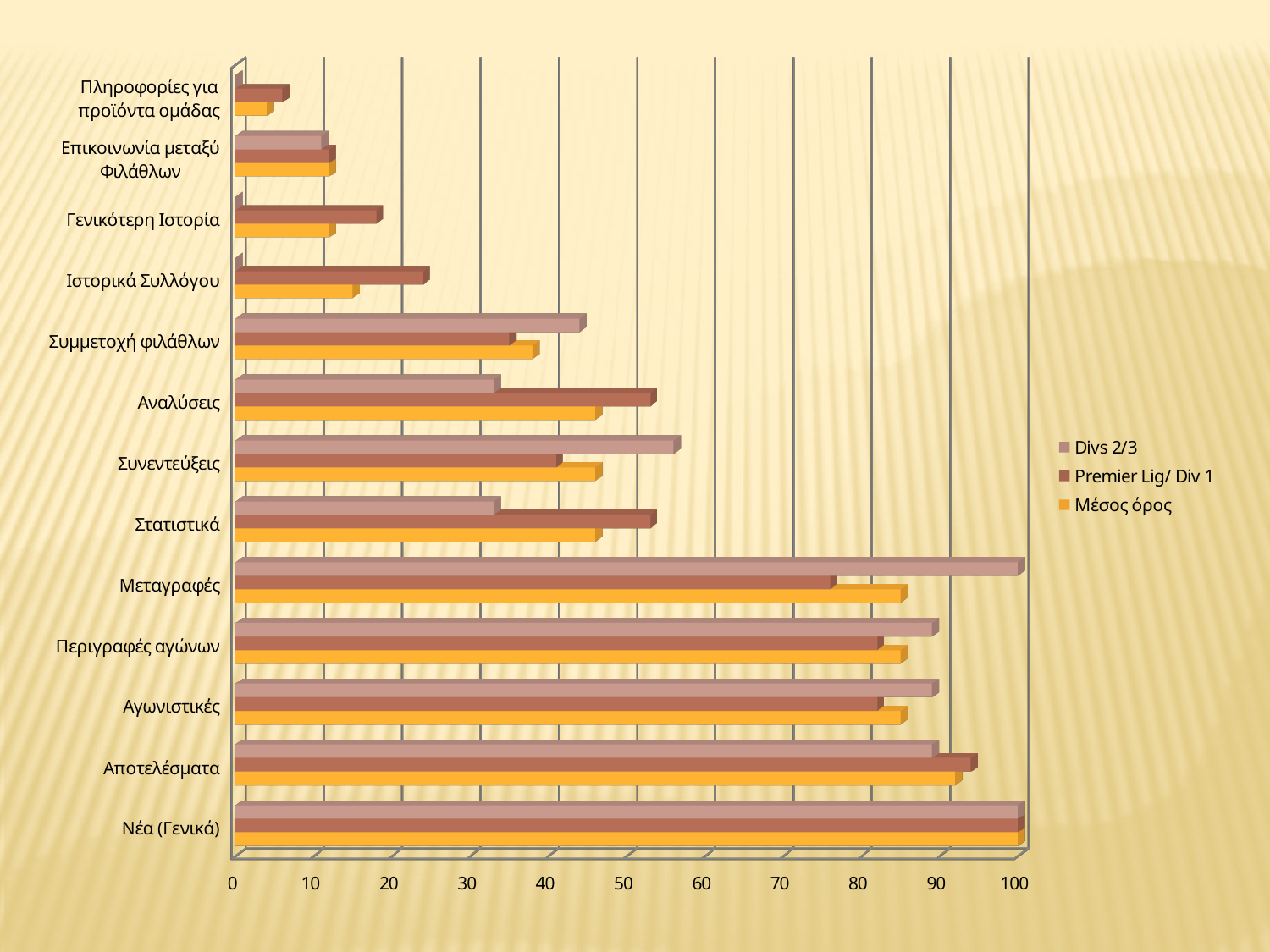
Which category has the lowest Μέσος όρος value? Πληροφορίες για προϊόντα ομάδας How many series does the legend list? 3 What kind of chart is shown on the slide? bar chart For Αναλύσεις, which series has the larger value: Divs 2/3 or Premier Lig/ Div 1? Premier Lig/ Div 1 Is the Divs 2/3 value for Συνεντεύξεις greater or less than 50? greater What is the Divs 2/3 value for Νέα (Γενικά)? 100 Is the Premier Lig/ Div 1 value for Μεταγραφές greater or less than 80? less What is the Divs 2/3 value for Μεταγραφές? 100 How many categories are plotted on the chart? 13 What are the three series named in the legend? Divs 2/3, Premier Lig/ Div 1, Μέσος όρος For Μεταγραφές, which series has the larger value: Divs 2/3 or Premier Lig/ Div 1? Divs 2/3 Is the Premier Lig/ Div 1 value for Ιστορικά Συλλόγου greater or less than 20? greater